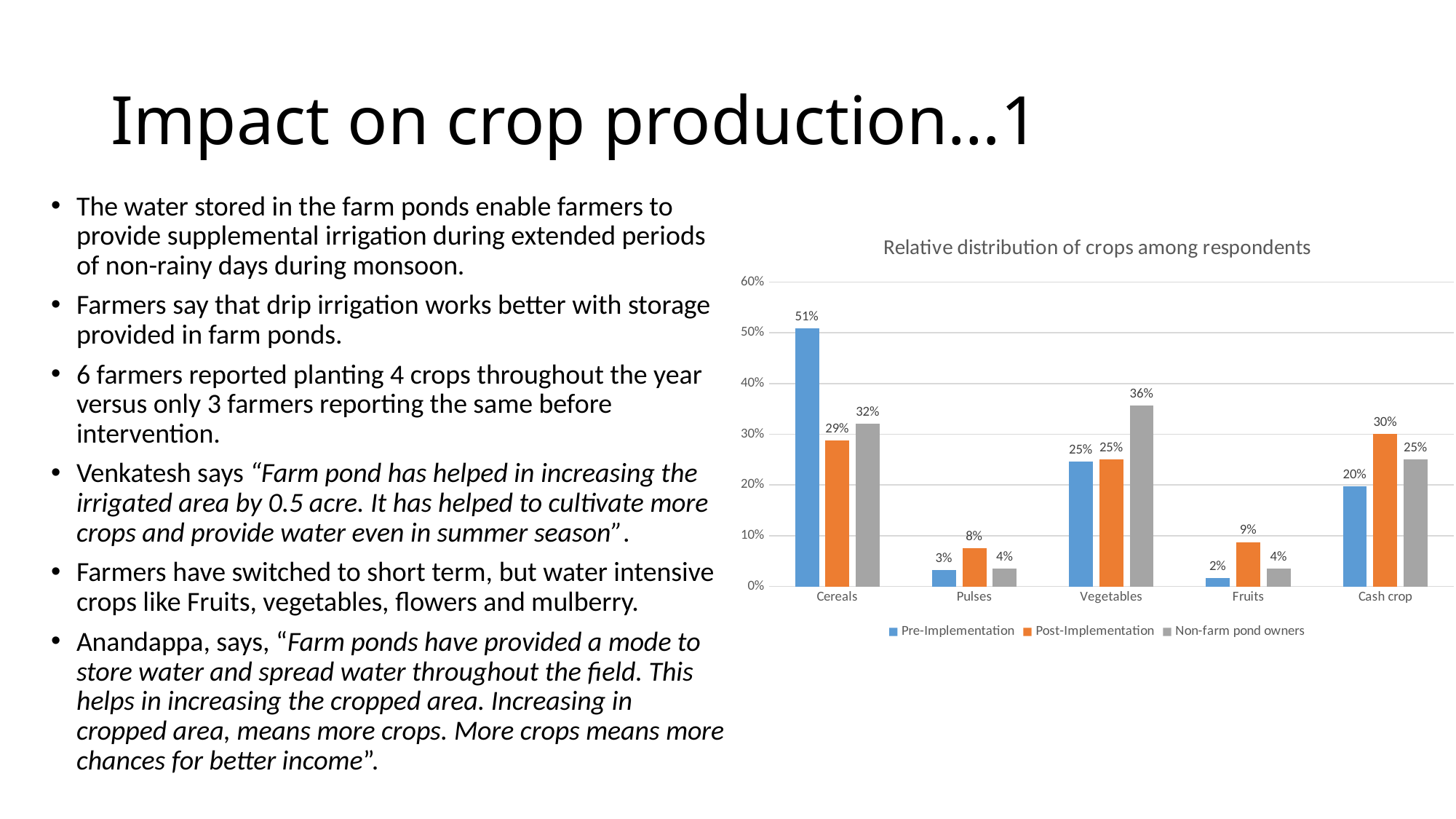
Which crop category has the highest Pre-Implementation value? Cereals How many crop categories are shown on the x axis? 5 What is the Post-Implementation value for Cash crop? 30% How many series does the legend list? 3 Which crop category has the lowest Post-Implementation value? Pulses What is the difference between the Pre-Implementation and Post-Implementation values for Cereals? 22% What kind of chart is shown on the slide? Bar chart What is the title of the chart? Relative distribution of crops among respondents Which is larger for Fruits: the Post-Implementation value or the Non-farm pond owners value? Post-Implementation What is the Non-farm pond owners value for Vegetables? 36% What is the Pre-Implementation value for Cereals? 51% Is the Non-farm pond owners value for Cereals greater or less than 40%? less